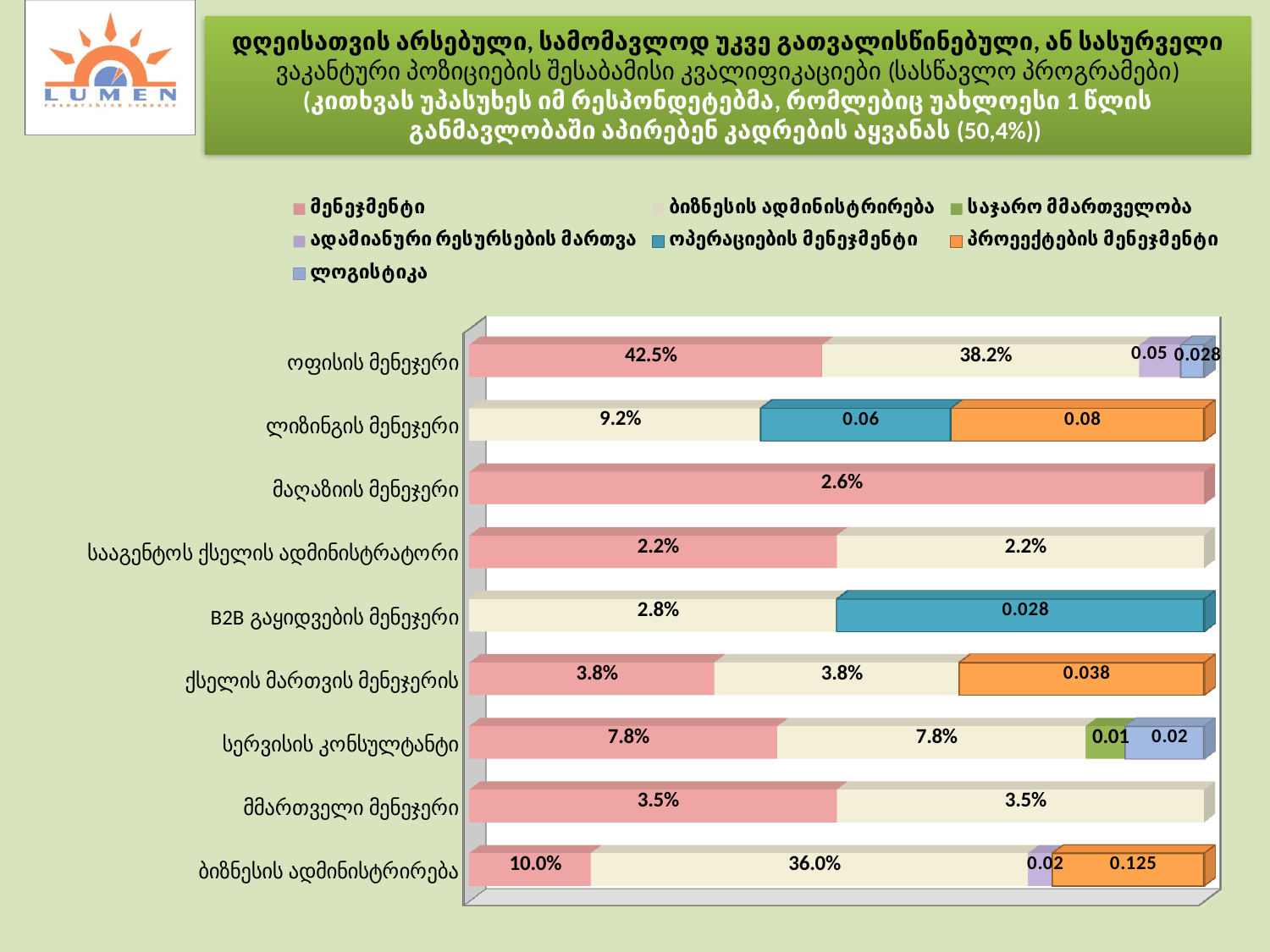
What is the value of the მენეჯმენტი series for სერვისის კონსულტანტი? 7.8% What is the difference between the მენეჯმენტი and ბიზნესის ადმინისტრირება values for ოფისის მენეჯერი? 4.3% What is the value of the მენეჯმენტი series for ოფისის მენეჯერი? 42.5% What is the value of the ბიზნესის ადმინისტრირება series for the ბიზნესის ადმინისტრირება category? 36.0% What is the value of the ბიზნესის ადმინისტრირება series for ოფისის მენეჯერი? 38.2% What is the value of the პროექტების მენეჯმენტი series for ლიზინგის მენეჯერი? 0.08 How many series does the legend list? 7 Which is larger: the მენეჯმენტი value for ოფისის მენეჯერი or the მენეჯმენტი value for ბიზნესის ადმინისტრირება? ოფისის მენეჯერი What is the value of the ოპერაციების მენეჯმენტი series for B2B გაყიდვების მენეჯერი? 0.028 What is the difference between the ბიზნესის ადმინისტრირება and მენეჯმენტი values for the ბიზნესის ადმინისტრირება category? 26.0% How many categories are shown on the chart? 9 What kind of chart is shown on the slide? Stacked bar chart